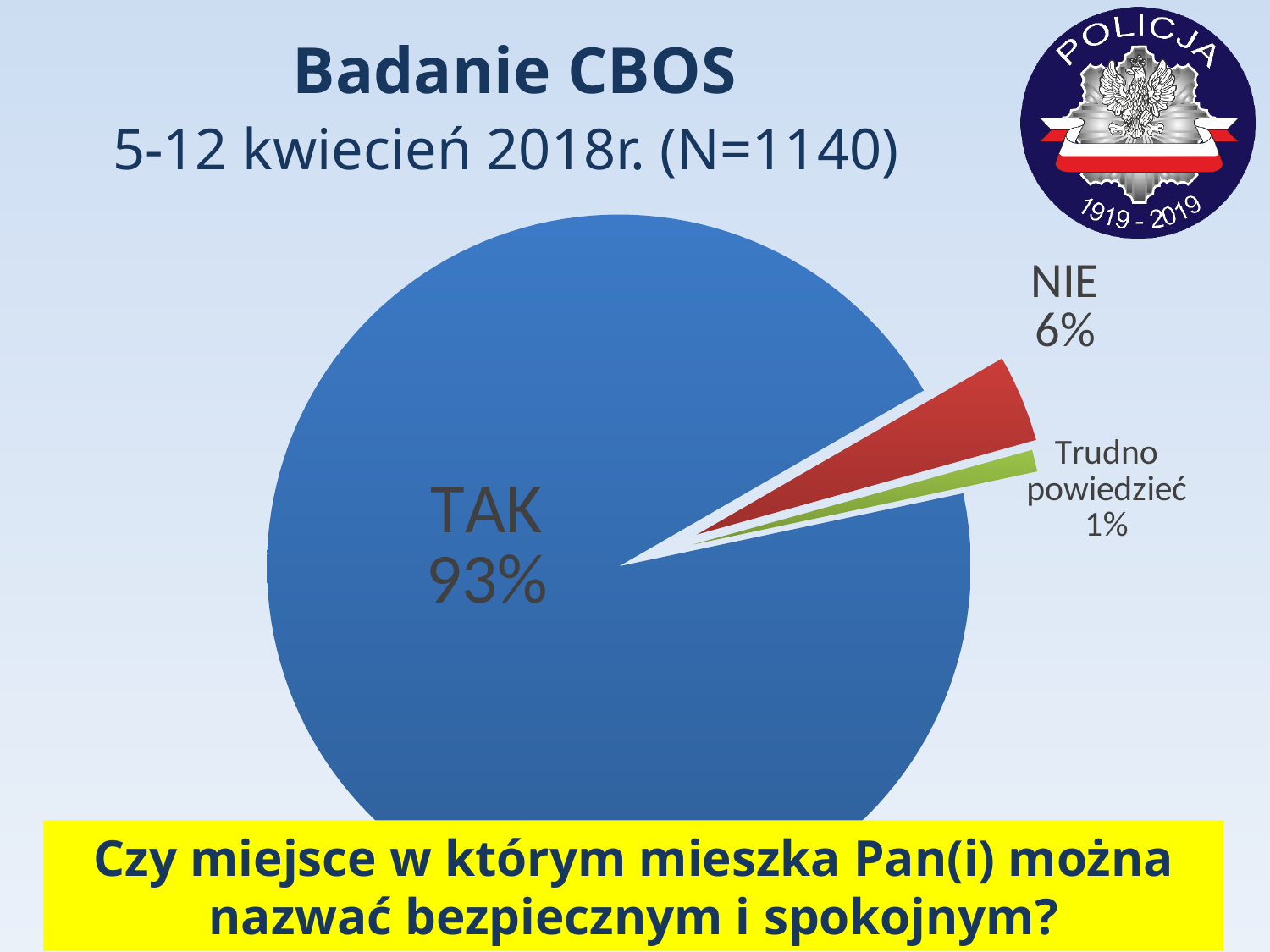
How many slices does the pie chart have? 3 What percentage of respondents answered Trudno powiedzieć? 1% What is the sample size (N) stated in the slide title? 1140 Which answer has the largest share of the pie? TAK Which is larger, the share for NIE or the share for Trudno powiedzieć? NIE What percentage of respondents answered NIE? 6% What percentage of respondents answered TAK? 93% What kind of chart is shown on the slide? pie chart What is the difference in percentage points between TAK and NIE? 87 What colour is the TAK slice of the pie? blue Which answer has the smallest share of the pie? Trudno powiedzieć What is the difference in percentage points between NIE and Trudno powiedzieć? 5